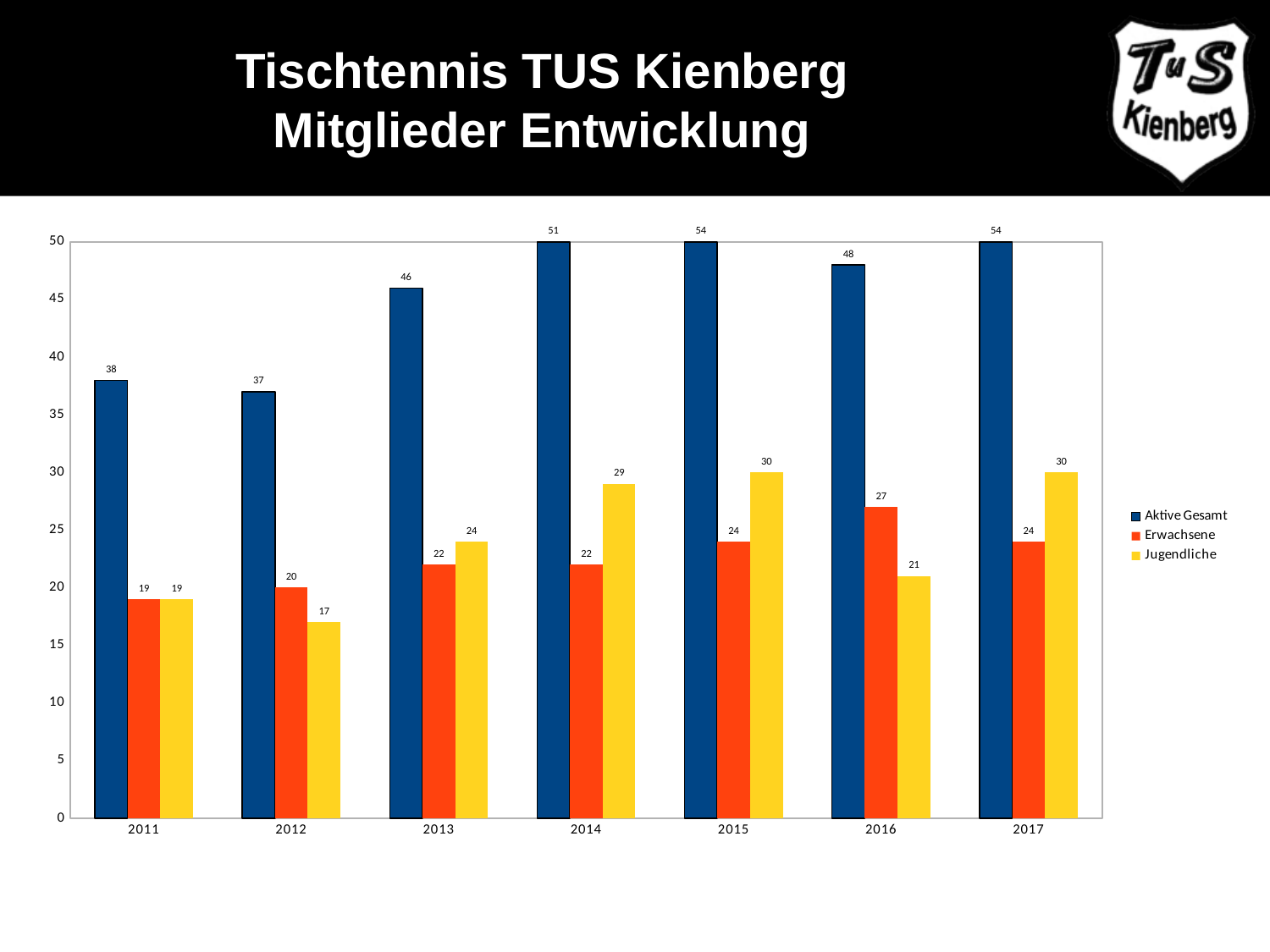
In which year is the Erwachsene value highest? 2016 What kind of chart is shown on the slide? Bar chart What is the value for Erwachsene in 2016? 27 How many series does the legend list? 3 What is the value for Aktive Gesamt in 2013? 46 Which series is shown in yellow in the legend? Jugendliche Does the Jugendliche value rise or fall from 2012 to 2015? Rise In which year is the Jugendliche value lowest? 2012 How many years are shown on the x axis? 7 Which is larger in 2016, Erwachsene or Jugendliche? Erwachsene What is the difference between the Aktive Gesamt values for 2015 and 2011? 16 What is the value for Jugendliche in 2014? 29